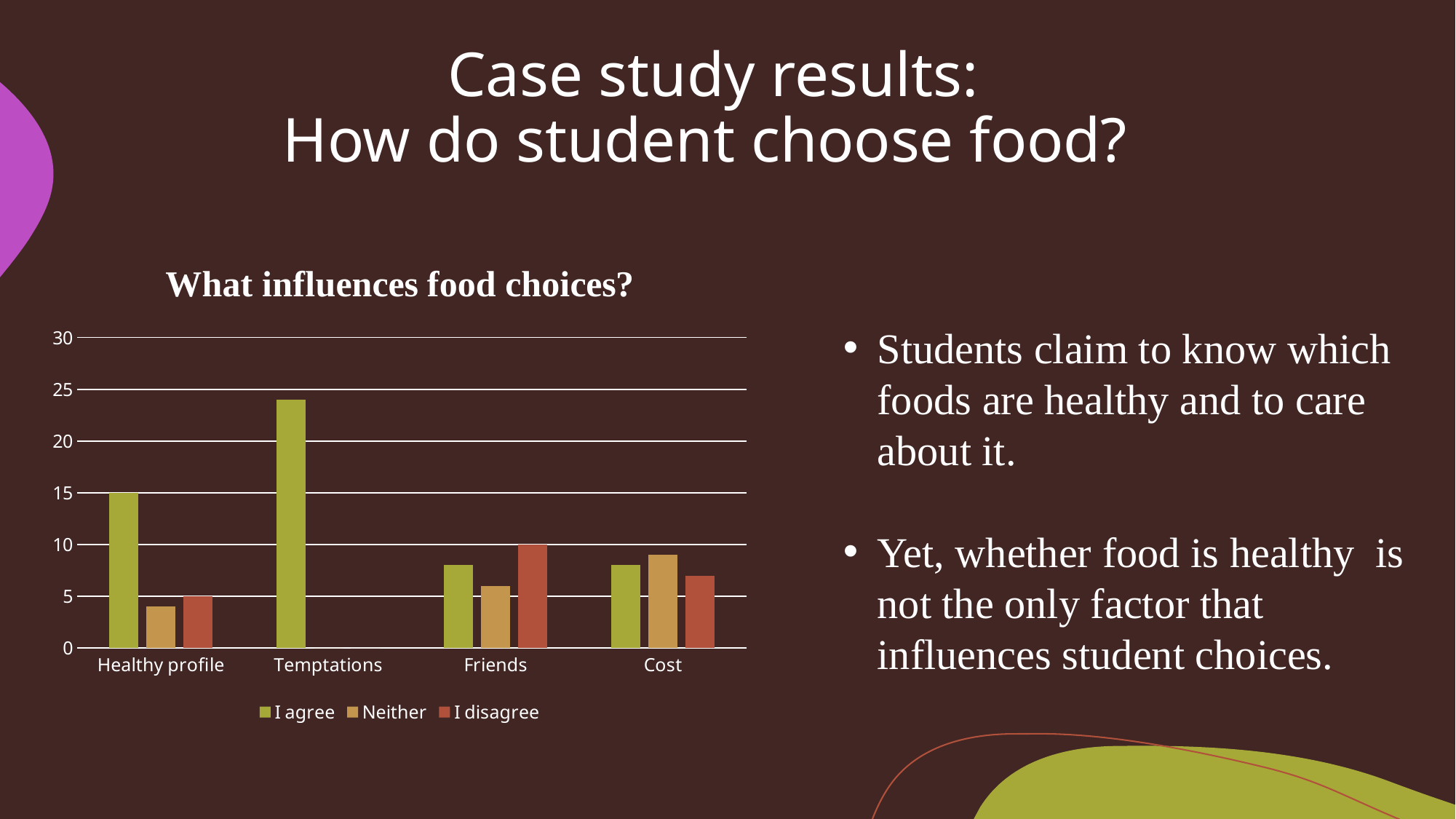
How many categories are shown on the x axis of the chart? 4 What is the title of the chart? What influences food choices? Is the 'Neither' value for Cost greater or less than 10? less Which category has the highest 'I agree' value? Temptations For Friends, which is larger: 'I agree' or 'I disagree'? I disagree Which series is shown in green in the chart legend? I agree How many series does the chart legend list? 3 What kind of chart is shown on the slide? bar chart Is the 'Neither' value for Healthy profile greater or less than 5? less What is the value of 'I disagree' for Friends? 10 Is the 'I agree' value for Temptations greater or less than 20? greater What is the value of 'I agree' for Healthy profile? 15